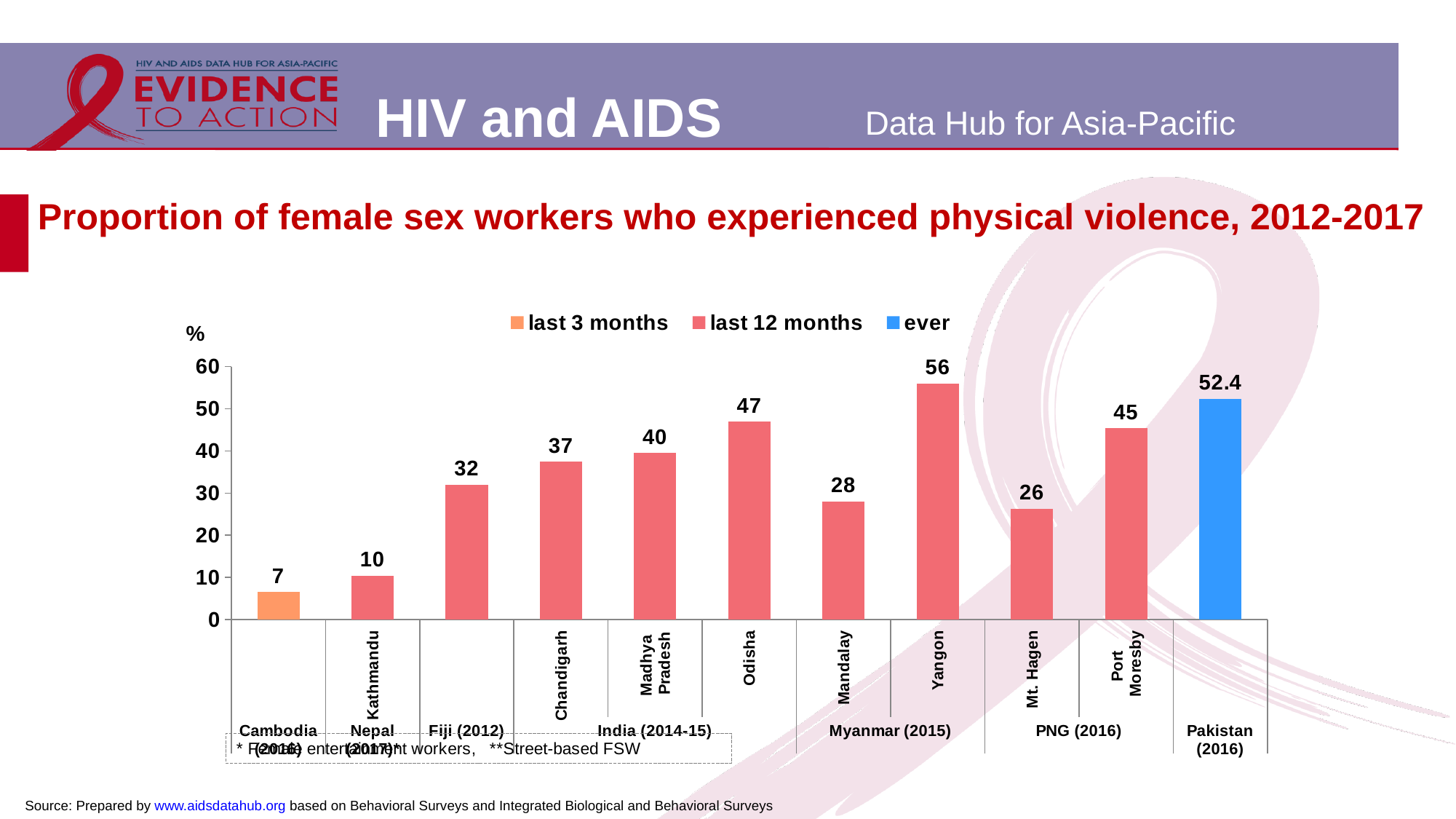
How many series does the legend list? 3 What is the value for Odisha? 47 Which has a larger value, Chandigarh or Mandalay? Chandigarh What is the difference between the values for Port Moresby and Mt. Hagen? 19 Which series does the Pakistan (2016) bar belong to, according to the legend? ever What is the value for Fiji (2012)? 32 How many bars are plotted on the chart? 11 Which location has the lowest value on the chart? Cambodia (2016) What kind of chart is shown on the slide? Bar chart Which location has the highest value on the chart? Yangon What is the value for Yangon? 56 What is the value for Pakistan (2016)? 52.4